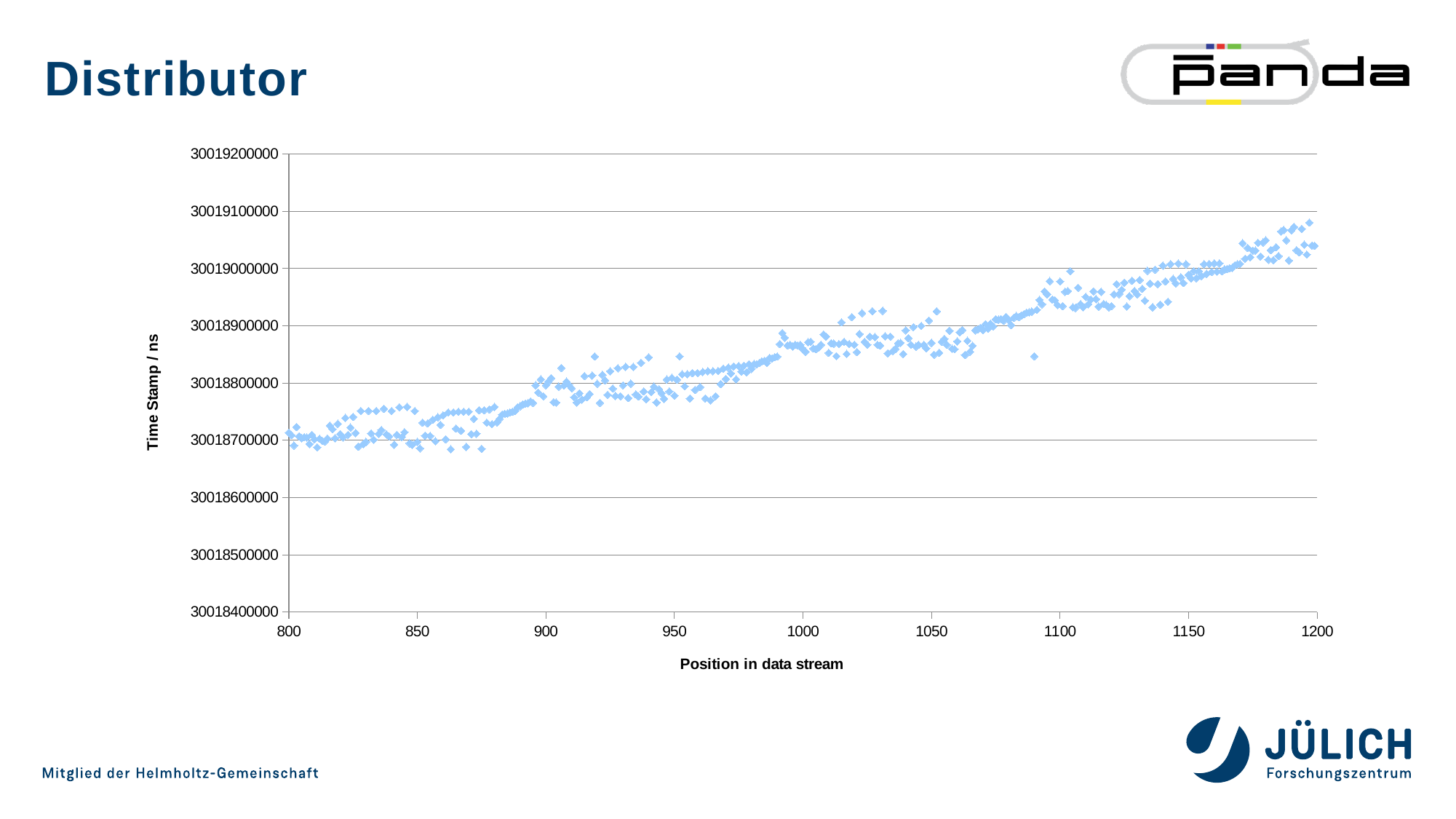
Are the time stamp values at position 800 greater or less than 30018800000? less Which has the larger time stamp values: the points near position 800 or the points near position 1200? Position 1200 Are the time stamp values around position 1100 greater or less than 30019000000? less Are the time stamp values around position 850 greater or less than 30018800000? less How many data series are plotted in the chart? 1 What is the lowest value shown on the y axis? 30018400000 What is the label of the x axis of the chart? Position in data stream What is the label of the y axis of the chart? Time Stamp / ns Do the time stamp values rise or fall as the position in the data stream increases from 800 to 1200? Rise What kind of chart is shown on the slide? Scatter plot